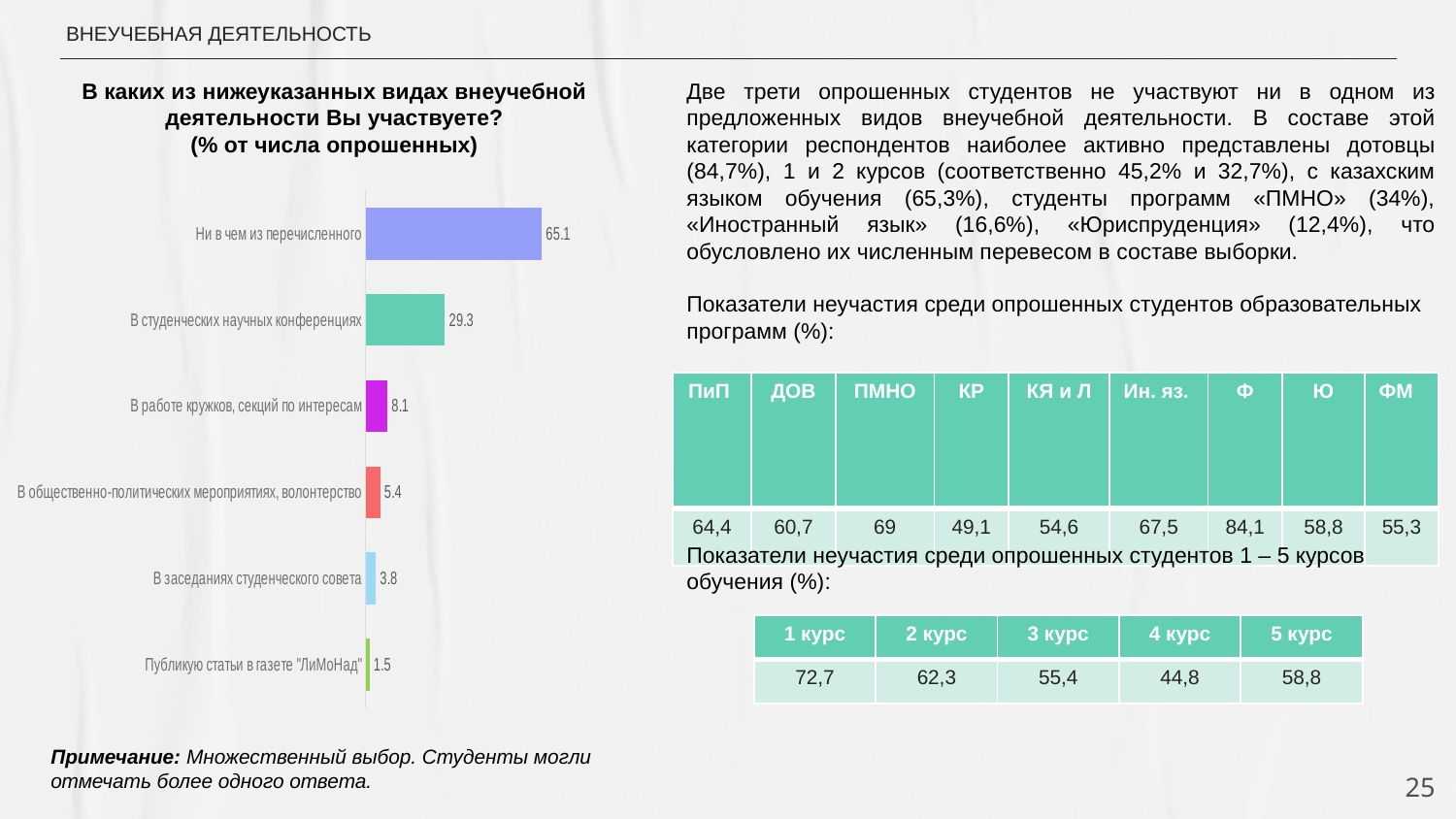
What is the difference between the values for "Ни в чем из перечисленного" and "В студенческих научных конференциях"? 35.8 Which category has the lowest value in the chart? Публикую статьи в газете "ЛиМоНад" What value is shown for "В работе кружков, секций по интересам"? 8.1 What value is shown for "Публикую статьи в газете "ЛиМоНад""? 1.5 What is the title of the chart? В каких из нижеуказанных видах внеучебной деятельности Вы участвуете? (% от числа опрошенных) What value is shown for "В студенческих научных конференциях"? 29.3 What type of chart is shown on the slide? Bar chart What is the difference between the values for "В работе кружков, секций по интересам" and "В заседаниях студенческого совета"? 4.3 What value is shown for "Ни в чем из перечисленного"? 65.1 Which is larger: the value for "В общественно-политических мероприятиях, волонтерство" or for "В заседаниях студенческого совета"? В общественно-политических мероприятиях, волонтерство Which category has the highest value in the chart? Ни в чем из перечисленного How many categories are shown in the bar chart? 6